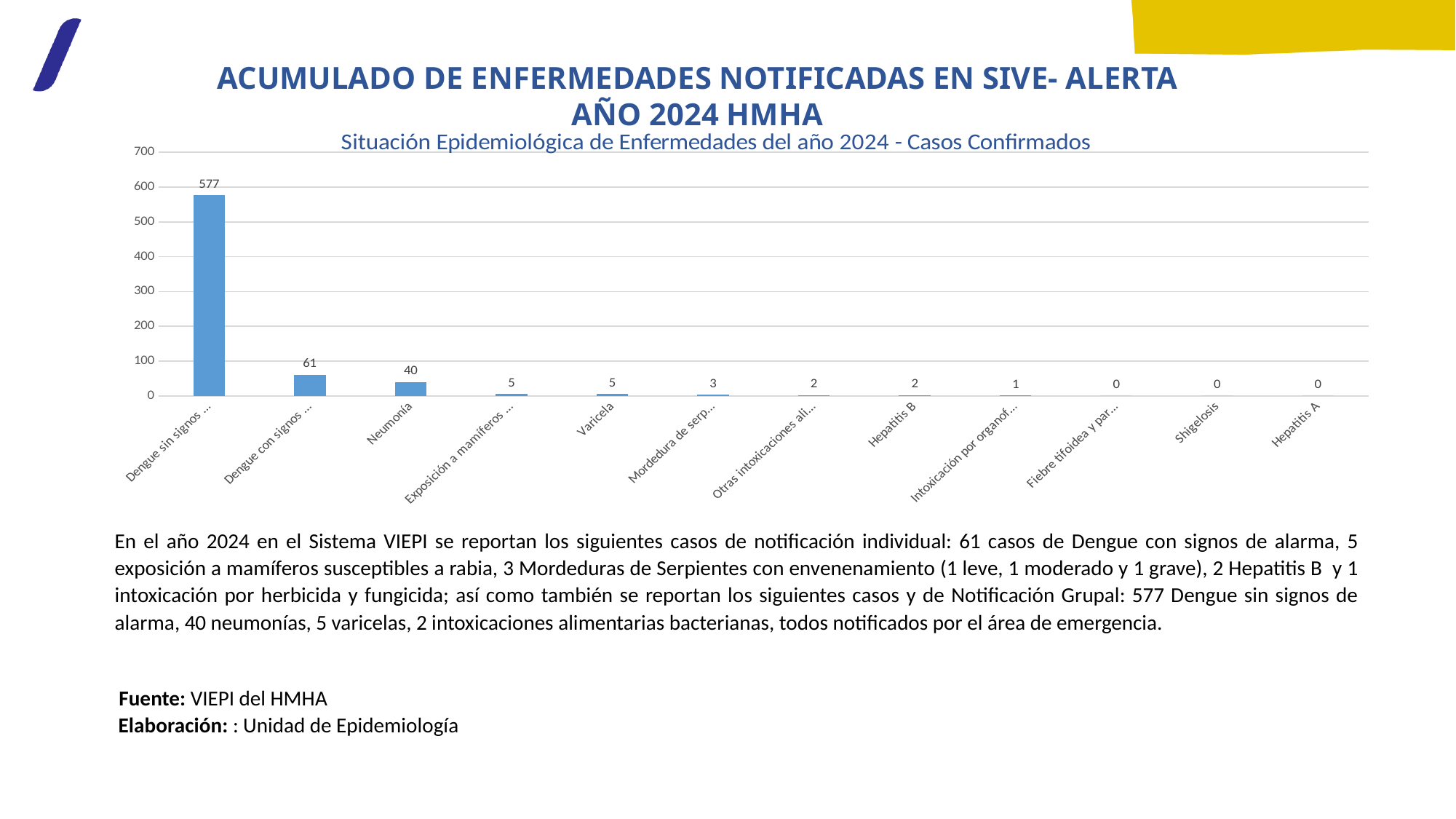
Which category has the highest value in the chart? Dengue sin signos de alarma What is the title of the chart? Situación Epidemiológica de Enfermedades del año 2024 - Casos Confirmados What is the difference between the values for Neumonía and Varicela? 35 How many categories are shown on the x axis of the chart? 12 What type of chart is shown on the slide? Bar chart What is the value for Neumonía? 40 What is the value for Varicela? 5 What is the value for Hepatitis A? 0 What is the value for Hepatitis B? 2 What is the value for Shigelosis? 0 Which is larger, the value for Neumonía or the value for Hepatitis B? Neumonía Do the values generally rise or fall from left to right along the x axis? Fall